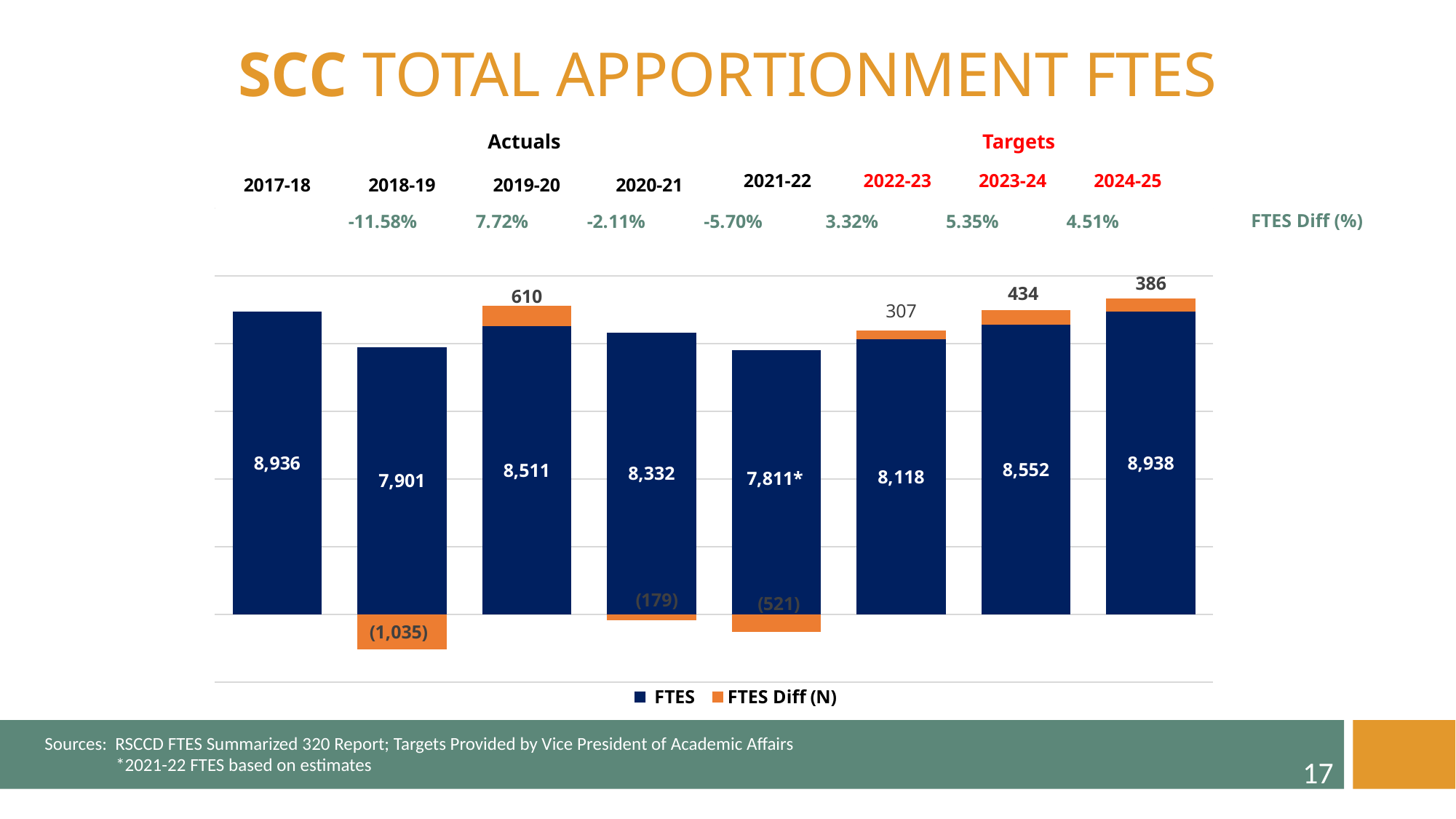
What is the FTES value for 2017-18? 8,936 How many series does the legend list? 2 Which year has the lowest FTES value? 2021-22 What is the FTES value for 2023-24? 8,552 Which year has the largest positive FTES Diff (N)? 2019-20 Which is larger, the FTES value for 2019-20 or for 2020-21? 2019-20 Do the FTES values rise or fall from 2021-22 to 2024-25? rise What is the FTES Diff (N) value for 2019-20? 610 What is the difference between the FTES values for 2017-18 and 2018-19? 1,035 What kind of chart is shown on the slide? bar chart How many years are shown on the x axis of the chart? 8 What is the FTES Diff (N) value for 2018-19? (1,035)